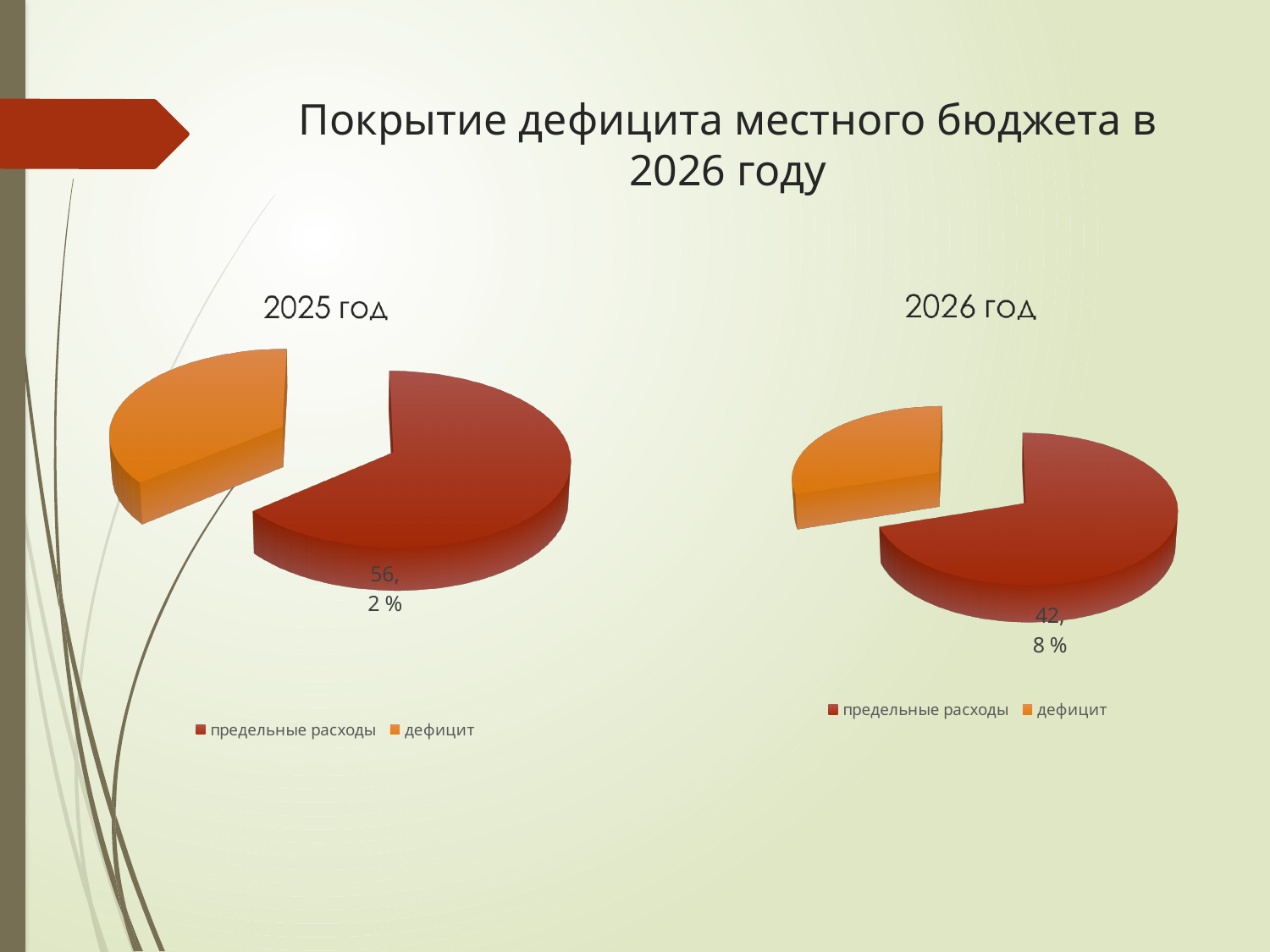
How many entries does the legend of the 2026 год chart list? 2 What data label is printed on the 2026 год chart? 42,8 % In the 2026 год chart, which slice is the smallest? дефицит How many charts are shown on the slide? 2 How many slices does the 2025 год pie chart have? 2 What data label is printed on the 2025 год chart? 56,2 % What are the two legend entries shown under the 2025 год chart? предельные расходы, дефицит Which chart shows the larger printed data label, 2025 год or 2026 год? 2025 год What is the difference between the data label on the 2025 год chart (56,2 %) and the data label on the 2026 год chart (42,8 %)? 13,4 % What kind of chart is used for the 2025 год chart? pie chart In the 2026 год chart, which slice is the largest? предельные расходы In the 2025 год chart, which slice is larger: предельные расходы or дефицит? предельные расходы